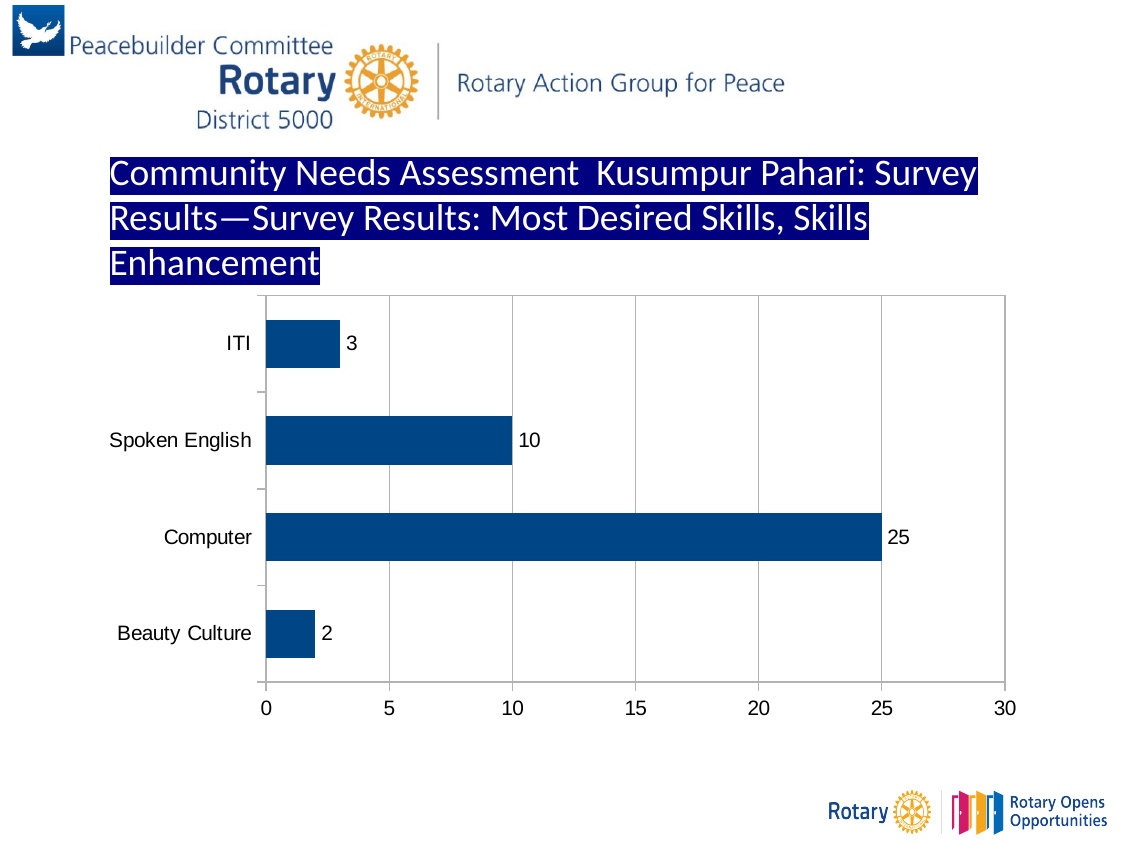
How many categories are shown in the chart? 4 Which category has the highest value? Computer Which category has the lowest value? Beauty Culture Is the value for Computer greater or less than 20? greater What is the value for Beauty Culture? 2 What is the value for ITI? 3 What is the value for Spoken English? 10 What kind of chart is shown on the slide? bar chart What is the difference between the values for Computer and Spoken English? 15 What is the total of all four values shown in the chart? 40 Which is larger, the value for Spoken English or the value for ITI? Spoken English What is the value for Computer? 25